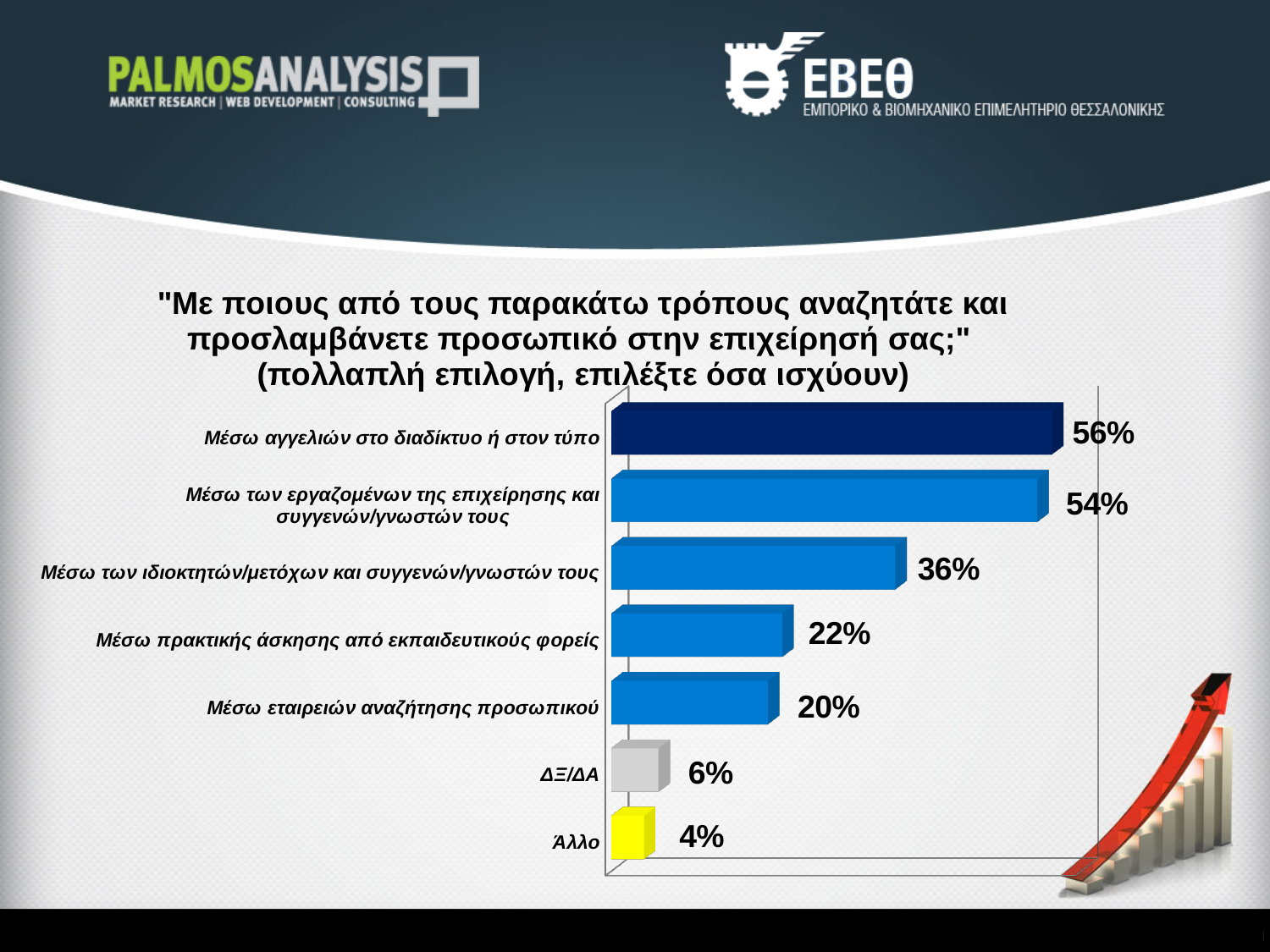
What is the value for "ΔΞ/ΔΑ"? 6% What is the difference between "Μέσω αγγελιών στο διαδίκτυο ή στον τύπο" and "Μέσω των εργαζομένων της επιχείρησης και συγγενών/γνωστών τους"? 2% What percentage is shown for "Μέσω εταιρειών αναζήτησης προσωπικού"? 20% Which is larger: the value for "Μέσω εταιρειών αναζήτησης προσωπικού" or the value for "ΔΞ/ΔΑ"? Μέσω εταιρειών αναζήτησης προσωπικού What colour is the bar for "Άλλο"? Yellow Which category has the highest value? Μέσω αγγελιών στο διαδίκτυο ή στον τύπο How many categories are shown in the chart? 7 What is the value for "Μέσω πρακτικής άσκησης από εκπαιδευτικούς φορείς"? 22% Which category has the lowest value? Άλλο What type of chart is shown on the slide? Bar chart What percentage is shown for "Μέσω αγγελιών στο διαδίκτυο ή στον τύπο"? 56% What is the difference between "Μέσω των ιδιοκτητών/μετόχων και συγγενών/γνωστών τους" and "Μέσω πρακτικής άσκησης από εκπαιδευτικούς φορείς"? 14%